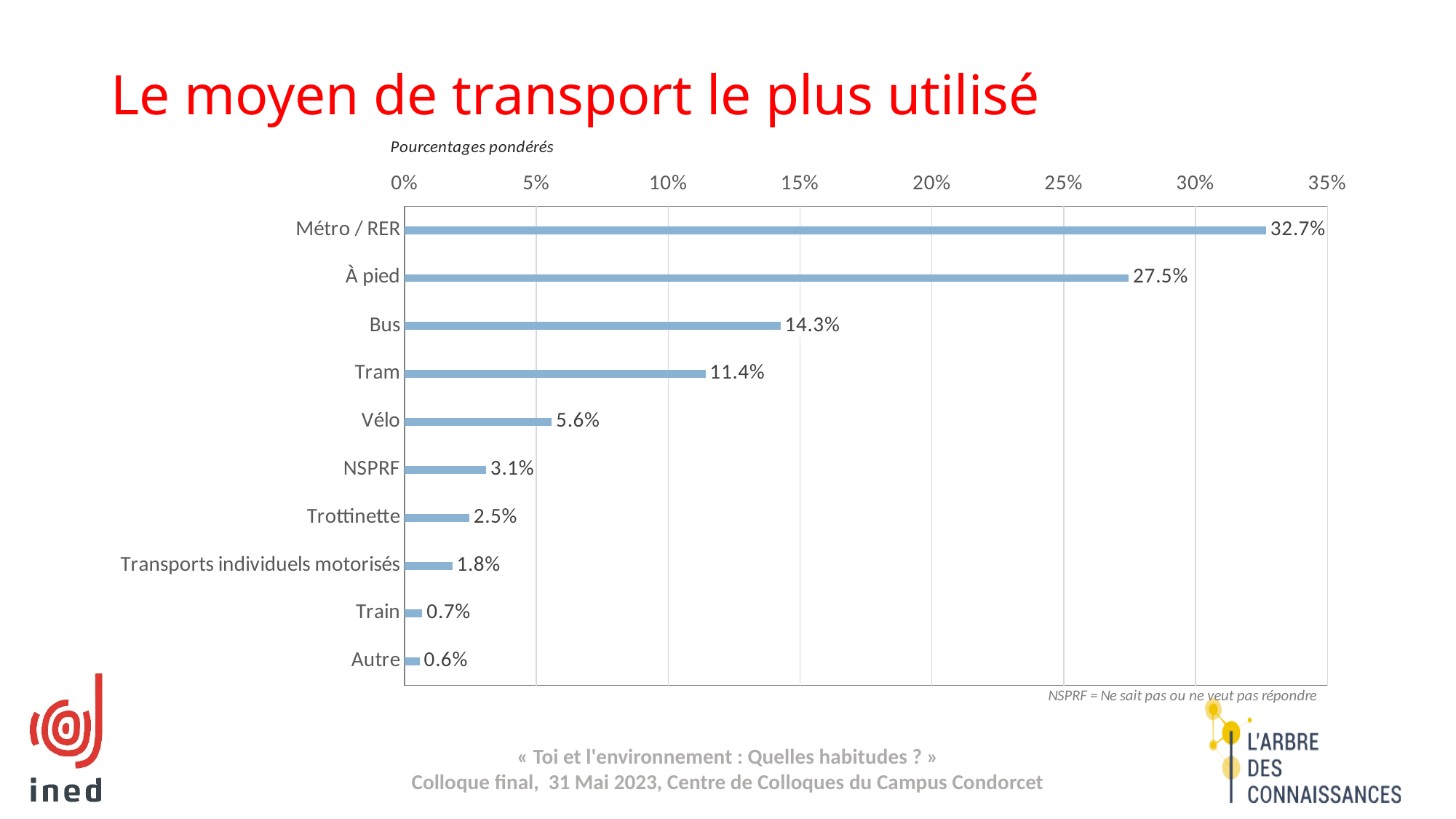
What is the title of the slide containing the chart? Le moyen de transport le plus utilisé What is the difference between the values for Bus and Tram? 2.9% What is the difference between the values for Métro / RER and À pied? 5.2% Is the value for À pied greater or less than 25%? greater Which category has the lowest value? Autre What is the value for Trottinette? 2.5% What kind of chart is shown on the slide? bar chart Which category has the highest value? Métro / RER Which is larger, the value for Tram or the value for Vélo? Tram What is the value for Bus? 14.3% What is the value for Métro / RER? 32.7% How many categories are shown in the chart? 10